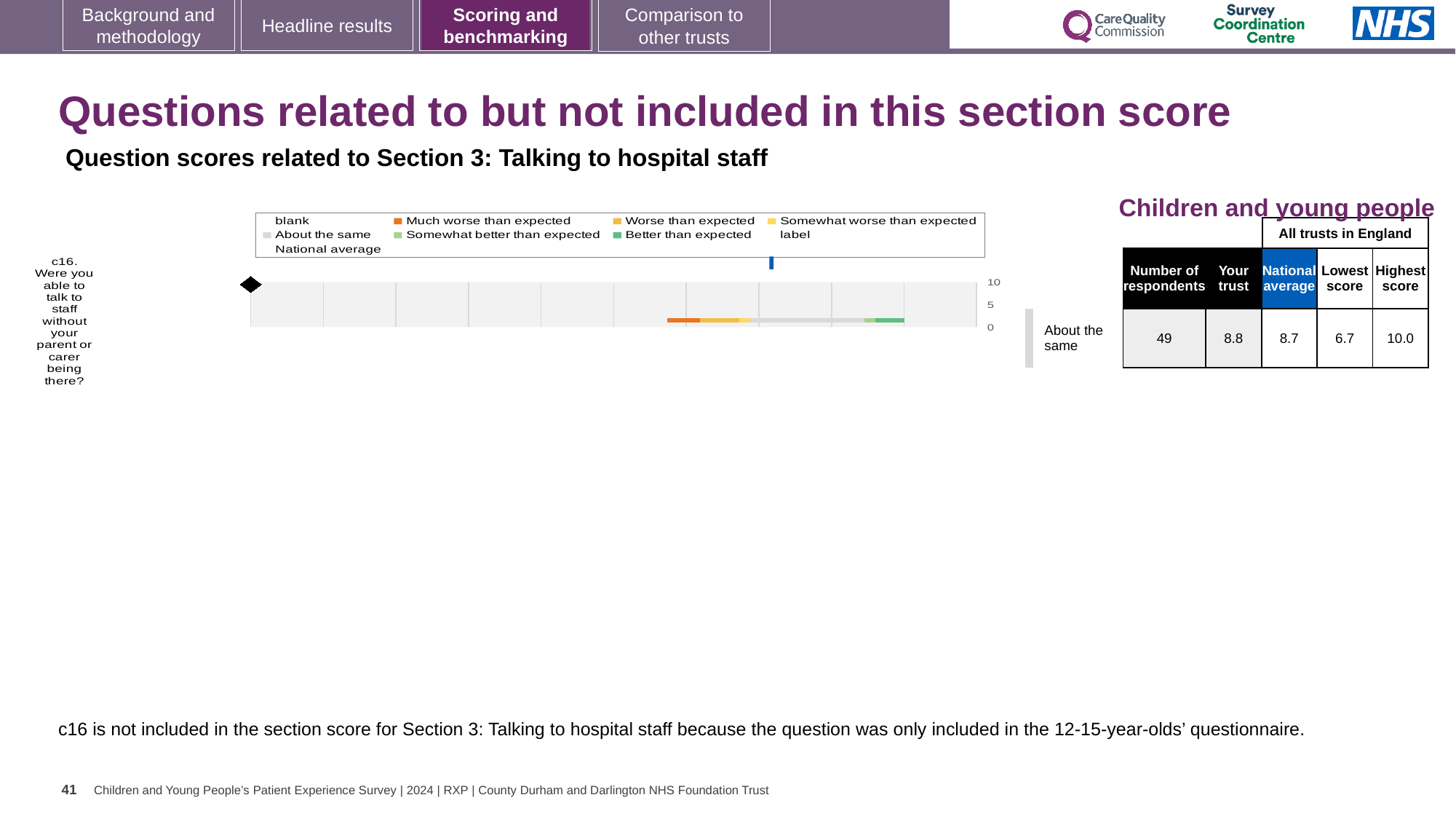
In the table beside the chart, what is the 'Your trust' score for c16? 8.8 What benchmark category is shown for c16 next to the chart? About the same For c16, which is larger: the 'Your trust' score or the national average? Your trust In the table beside the chart, how many respondents answered c16? 49 For c16, what is the difference between the highest score and the lowest score among all trusts in England? 3.3 In the table beside the chart, what is the lowest score among all trusts in England for c16? 6.7 What kind of chart is used to show the c16 question score? bar chart In the table beside the chart, what is the national average score for c16? 8.7 What is the highest value shown on the chart's axis? 10 In the table beside the chart, what is the highest score among all trusts in England for c16? 10.0 Which question is plotted in the chart? c16. Were you able to talk to staff without your parent or carer being there? How many questions are plotted in the chart? 1